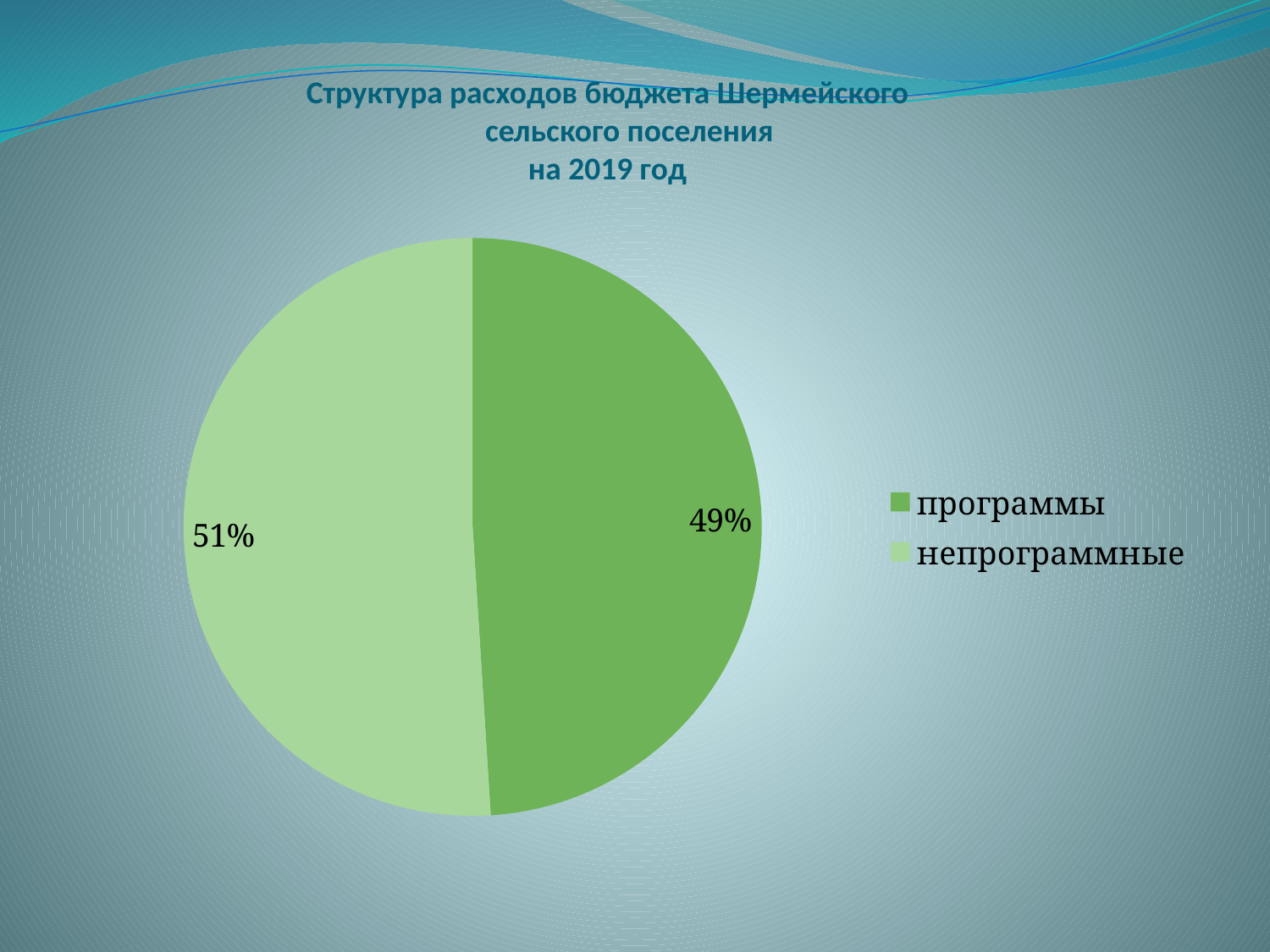
Which is larger: the share for "программы" or the share for "непрограммные"? непрограммные Which category has the largest share of the pie? непрограммные What share of the pie does the "непрограммные" slice represent? 51% What is the difference in percentage points between the "непрограммные" and "программы" slices? 2 Which category has the smallest share of the pie? программы What share of the pie does the "программы" slice represent? 49% What is the title of the chart? Структура расходов бюджета Шермейского сельского поселения на 2019 год How many entries does the legend list? 2 Which legend entry is shown in the darker green colour? программы What kind of chart is shown on the slide? pie chart How many slices does the pie chart have? 2